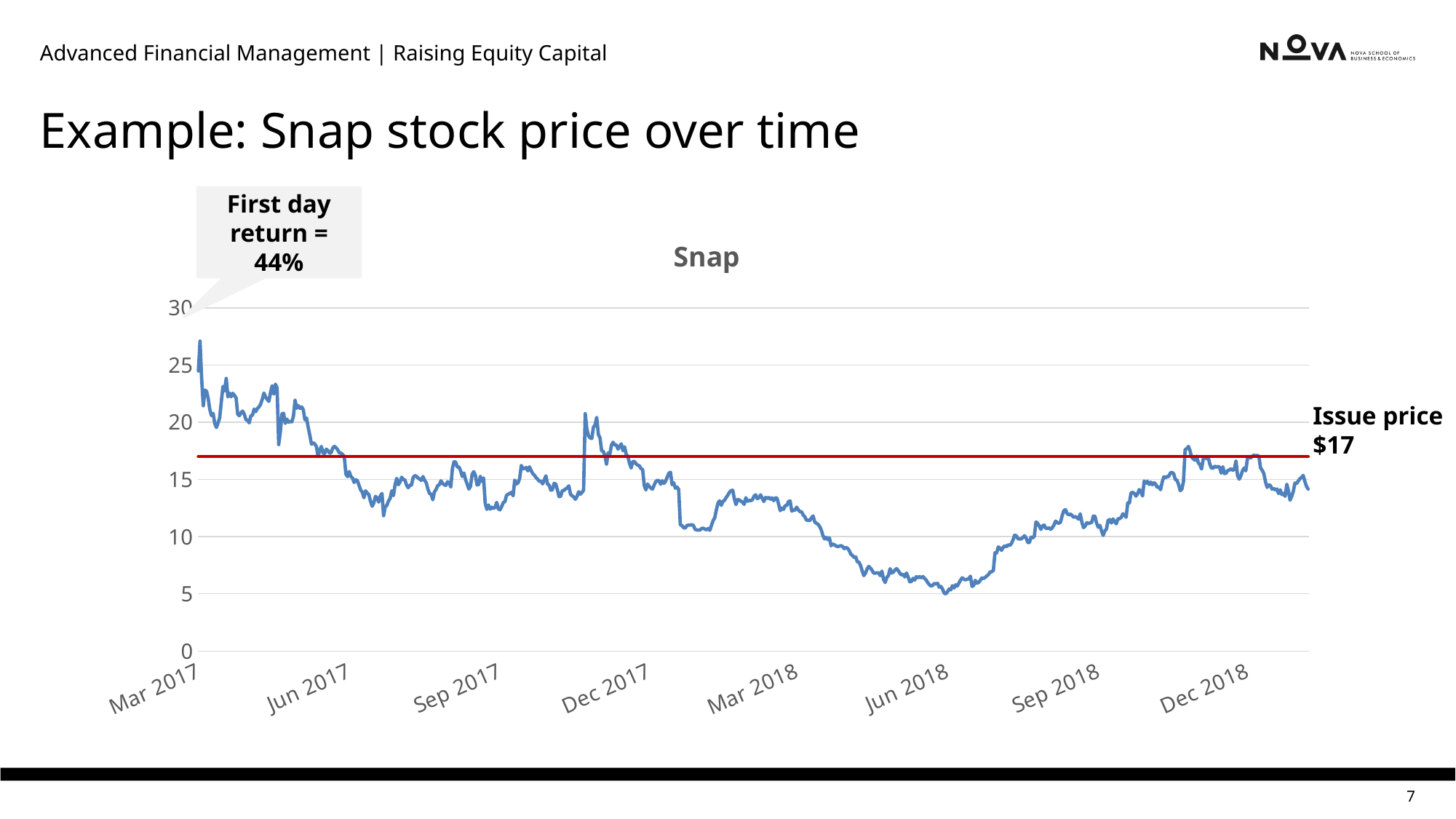
Is the Snap stock price around Mar 2018 higher or lower than around Jun 2018? higher What first day return is stated in the callout on the chart? 44% What is the title of the chart? Snap Does the Snap stock price rise or fall overall between Mar 2017 and Jun 2018? fall Around which x-axis label does the Snap stock price reach its highest point? Mar 2017 What kind of chart is shown on the slide? line chart Is the Snap stock price around Jun 2018 greater or less than 10? less Is the Snap stock price around Sep 2017 greater or less than 20? less What issue price is marked by the horizontal red line on the chart? $17 Is the Snap stock price at the start of the series in Mar 2017 greater or less than 20? greater Around which x-axis label does the Snap stock price reach its lowest point? Jun 2018 How many date labels are shown on the x axis of the chart? 8